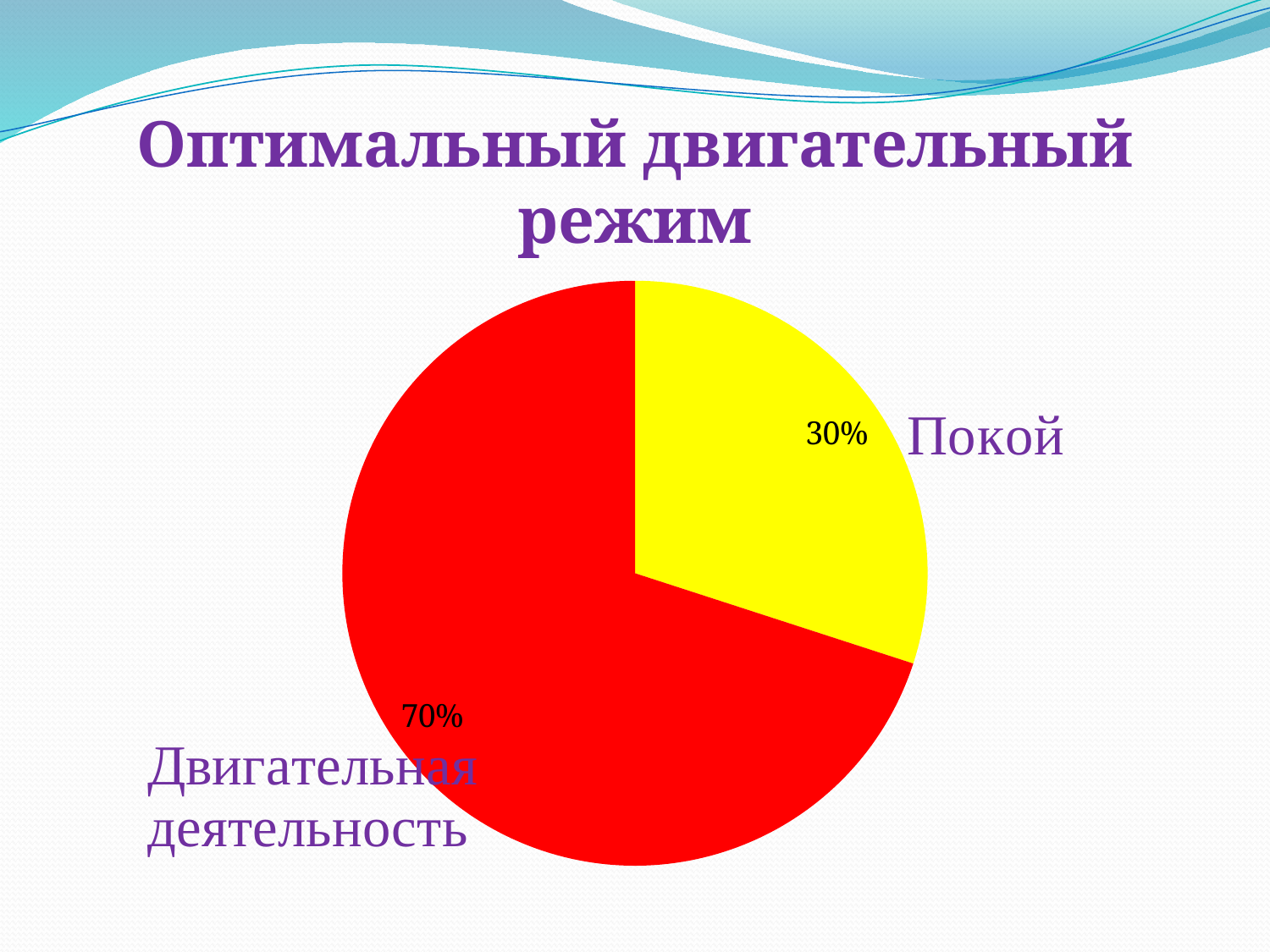
What is the difference between the values for Двигательная деятельность and Покой? 40% Which slice is the smallest? Покой Which is larger, Покой or Двигательная деятельность? Двигательная деятельность What is the title of the slide? Оптимальный двигательный режим What colour is the slice for Покой? yellow What share of the pie does Покой take? 30% How many slices does the pie chart have? 2 What is the value for Двигательная деятельность? 70% What is the value for Покой? 30% Which slice is the largest? Двигательная деятельность What kind of chart is shown on the slide? pie chart